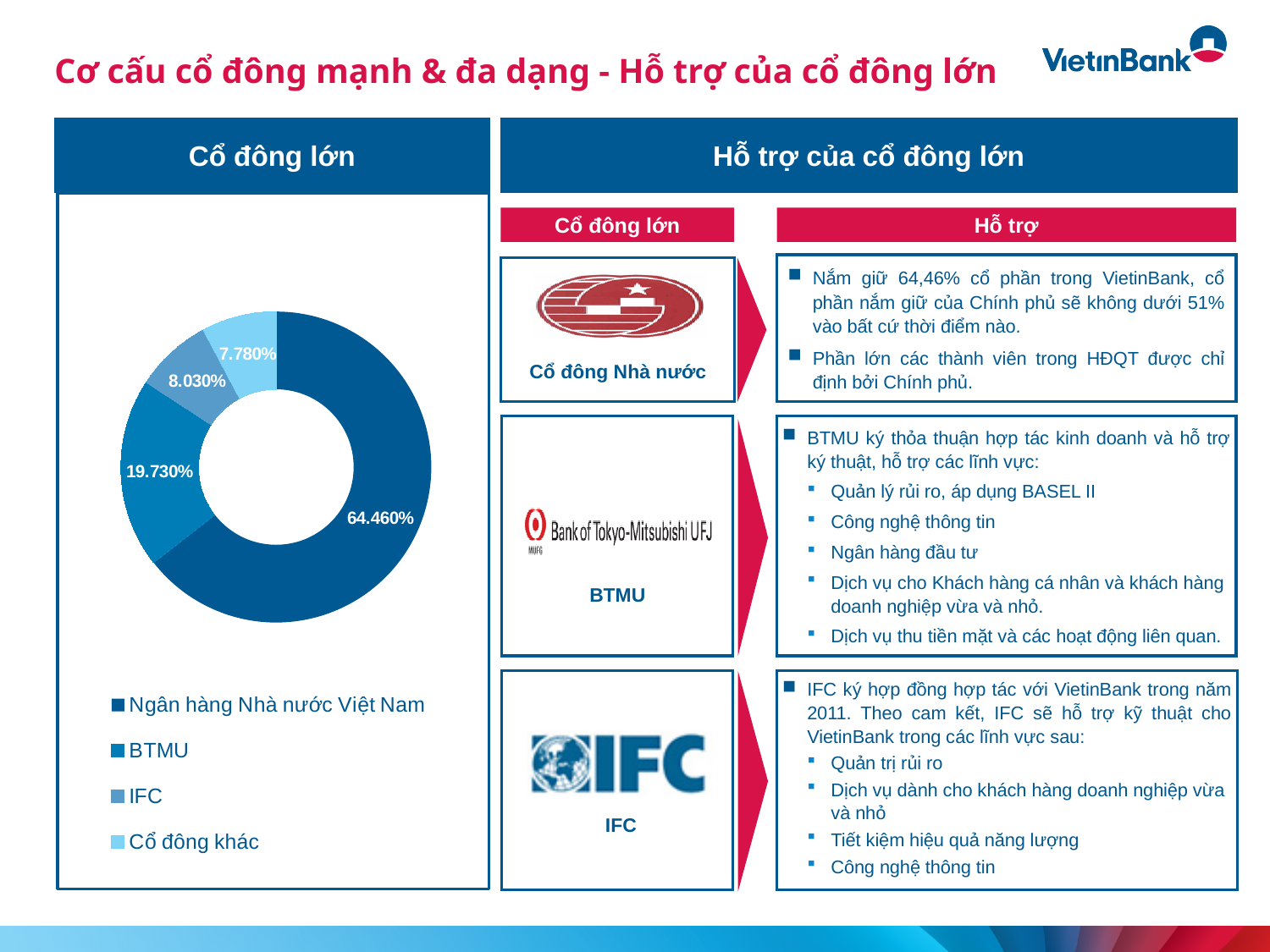
Which legend entry is listed first in the pie chart's legend? Ngân hàng Nhà nước Việt Nam What is the difference between the shares of Ngân hàng Nhà nước Việt Nam and BTMU in the pie chart? 44.730% What is the value shown for IFC in the pie chart? 8.030% What kind of chart is shown under the heading Cổ đông lớn? Doughnut chart How many categories are shown in the pie chart? 4 What is the value shown for Cổ đông khác in the pie chart? 7.780% Which category has the smallest slice in the pie chart? Cổ đông khác Which is larger in the pie chart, the share of IFC or the share of Cổ đông khác? IFC What is the combined share of BTMU and IFC in the pie chart? 27.760% What share of the pie chart does Ngân hàng Nhà nước Việt Nam hold? 64.460% Which category has the largest slice in the pie chart? Ngân hàng Nhà nước Việt Nam What is the value shown for BTMU in the pie chart? 19.730%